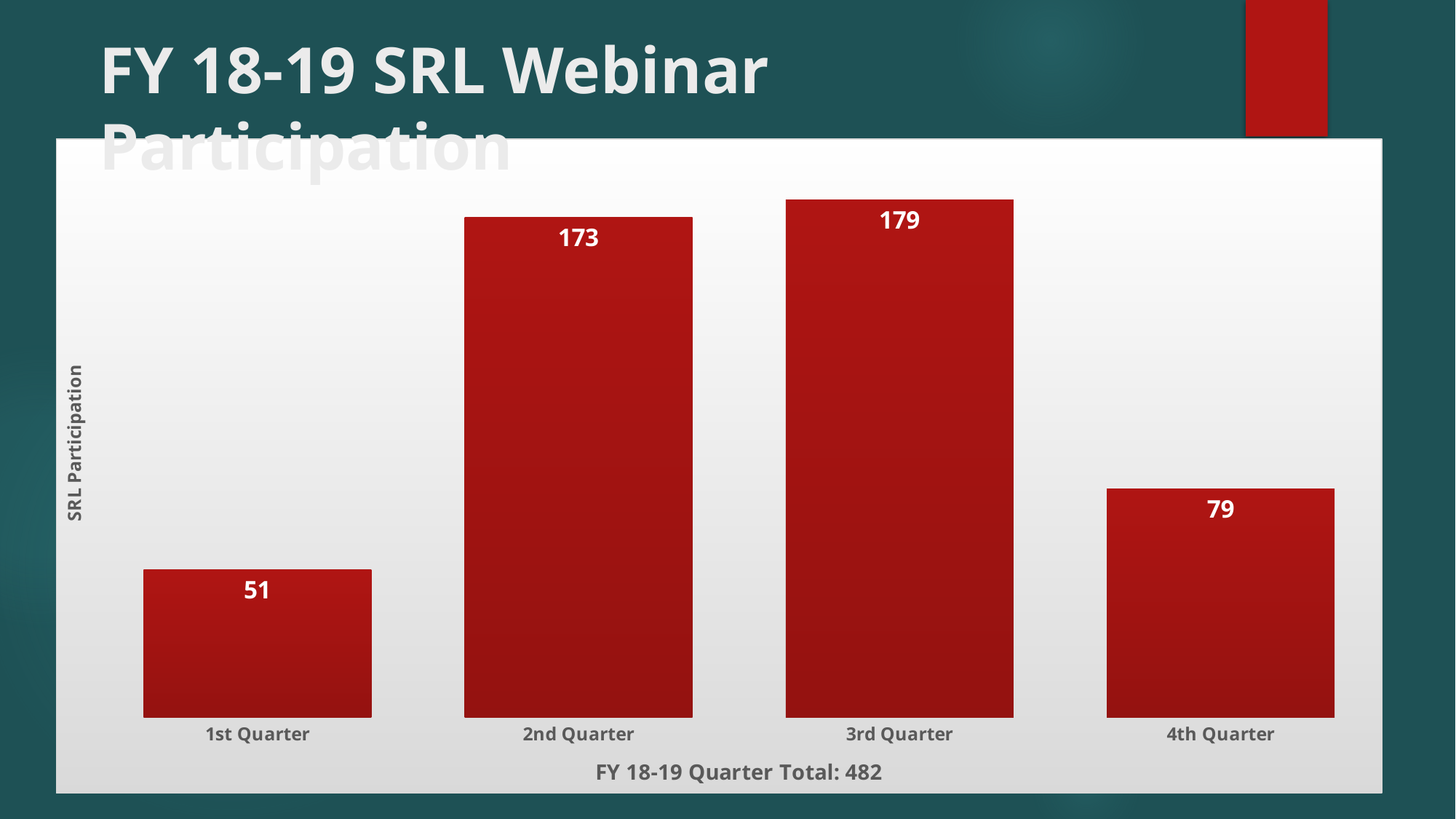
What is the SRL participation value for the 2nd Quarter? 173 How many quarters are shown in the chart? 4 What is the difference in SRL participation between the 3rd Quarter and the 2nd Quarter? 6 What kind of chart is shown on the slide? Bar chart What is the SRL participation value for the 1st Quarter? 51 What is the SRL participation value for the 3rd Quarter? 179 What is the difference in SRL participation between the 4th Quarter and the 1st Quarter? 28 Which quarter has the lowest SRL participation? 1st Quarter What is the FY 18-19 Quarter Total shown on the x-axis label? 482 What is the SRL participation value for the 4th Quarter? 79 Which has higher SRL participation, the 1st Quarter or the 4th Quarter? 4th Quarter Which quarter has the highest SRL participation? 3rd Quarter